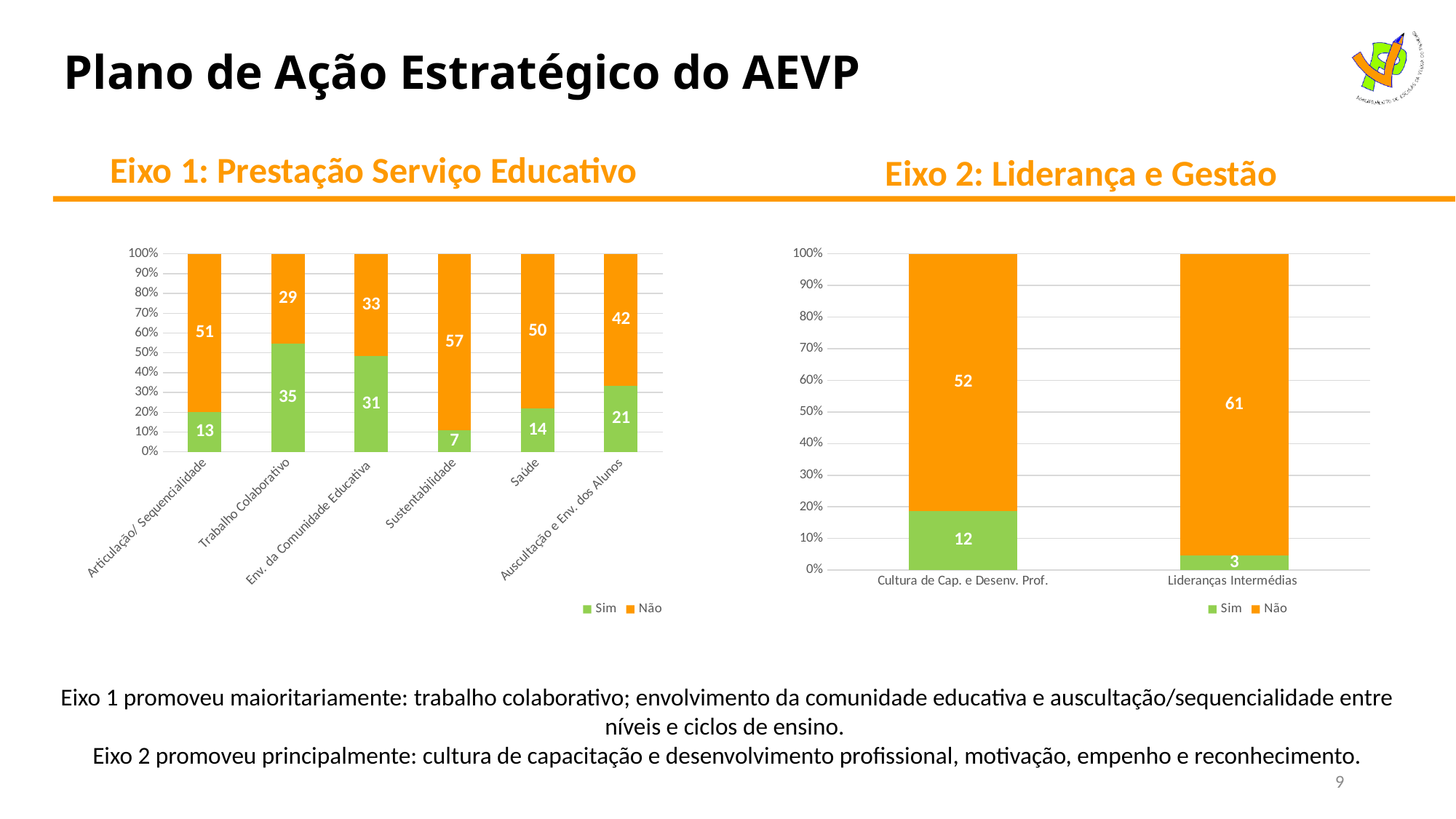
In the Eixo 1: Prestação Serviço Educativo chart, which category has the lowest Sim value? Sustentabilidade In the Eixo 2: Liderança e Gestão chart, which category has the larger Não value, Cultura de Cap. e Desenv. Prof. or Lideranças Intermédias? Lideranças Intermédias In the Eixo 2: Liderança e Gestão chart, what is the Sim value for Lideranças Intermédias? 3 In the Eixo 2: Liderança e Gestão chart, what is the Não value for Cultura de Cap. e Desenv. Prof.? 52 How many categories are shown in the Eixo 1: Prestação Serviço Educativo chart? 6 In the Eixo 1: Prestação Serviço Educativo chart, what is the total of the Sim and Não values for Articulação/ Sequencialidade? 64 In the Eixo 1: Prestação Serviço Educativo chart, what is the Sim value for Trabalho Colaborativo? 35 What kind of chart is the Eixo 2: Liderança e Gestão chart? Stacked bar chart In the Eixo 1: Prestação Serviço Educativo chart, which category has the highest Sim value? Trabalho Colaborativo In the Eixo 1: Prestação Serviço Educativo chart, what is the difference between the Não and Sim values for Saúde? 36 In the Eixo 1: Prestação Serviço Educativo chart, what is the Não value for Sustentabilidade? 57 How many series does the legend of the Eixo 2: Liderança e Gestão chart list? 2